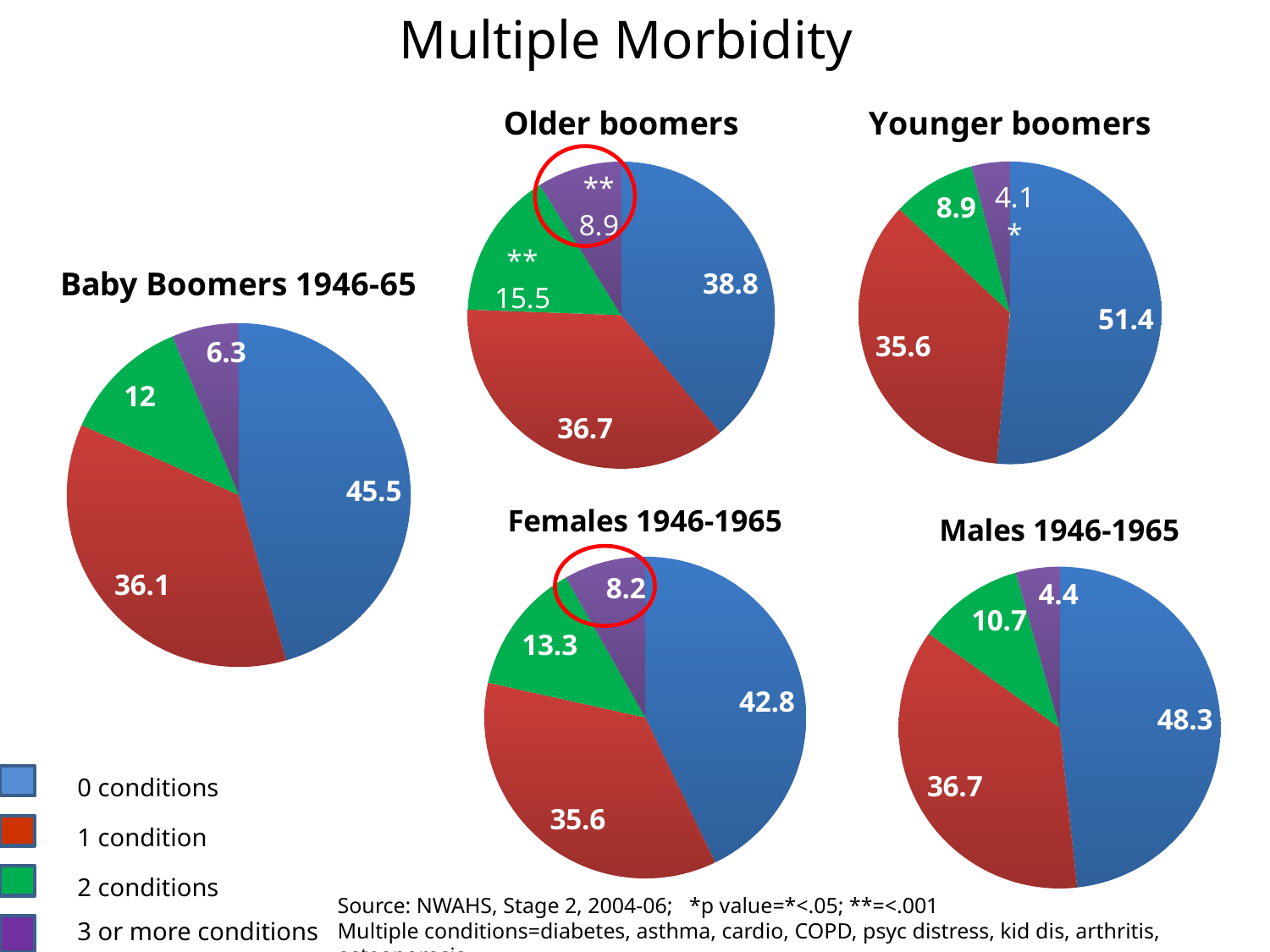
Which is larger: the 3 or more conditions value for Females 1946-1965 or for Males 1946-1965? Females 1946-1965 In the Older boomers pie chart, which category has the smallest slice? 3 or more conditions In the Younger boomers pie chart, which category has the largest slice? 0 conditions In the Males 1946-1965 pie chart, what is the difference between the 0 conditions value and the 1 condition value? 11.6 How many slices does the Baby Boomers 1946-65 pie chart have? 4 In the Baby Boomers 1946-65 pie chart, what is the value for 0 conditions? 45.5 What type of chart is used for Older boomers? Pie chart In the Females 1946-1965 pie chart, what is the value for 2 conditions? 13.3 In the Males 1946-1965 pie chart, what is the value for 3 or more conditions? 4.4 In the Older boomers pie chart, what is the value for 3 or more conditions? 8.9 In the Younger boomers pie chart, what is the value for 1 condition? 35.6 How many pie charts are shown on the slide? 5